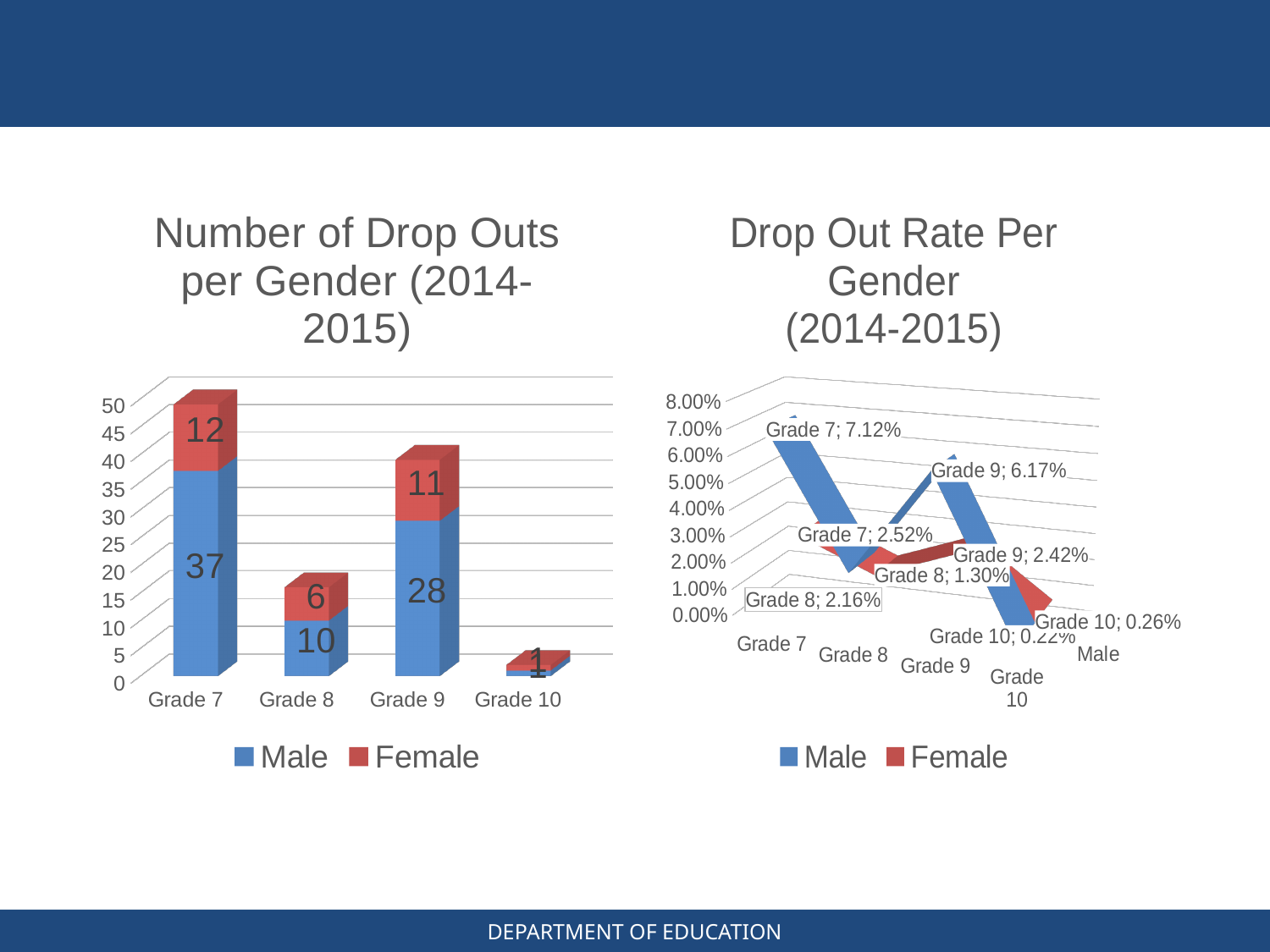
In the 'Number of Drop Outs per Gender (2014-2015)' chart, how many female drop outs are shown for Grade 9? 11 In the 'Drop Out Rate Per Gender (2014-2015)' chart, what is the male drop out rate for Grade 7? 7.12% In the 'Drop Out Rate Per Gender (2014-2015)' chart, what is the female drop out rate for Grade 9? 2.42% What type of chart is the 'Number of Drop Outs per Gender (2014-2015)' chart? Bar chart In the 'Number of Drop Outs per Gender (2014-2015)' chart, what is the total number of drop outs (male plus female) for Grade 7? 49 In the 'Number of Drop Outs per Gender (2014-2015)' chart, what is the total number of drop outs (male plus female) for Grade 8? 16 In the 'Number of Drop Outs per Gender (2014-2015)' chart, which grade has the highest number of male drop outs? Grade 7 How many series does the legend of the 'Drop Out Rate Per Gender (2014-2015)' chart list? 2 In the 'Number of Drop Outs per Gender (2014-2015)' chart, how many more male drop outs are there in Grade 7 than in Grade 9? 9 How many grade categories are shown on the x axis of the 'Number of Drop Outs per Gender (2014-2015)' chart? 4 In the 'Drop Out Rate Per Gender (2014-2015)' chart, which is larger for Grade 9: the male rate or the female rate? Male In the 'Number of Drop Outs per Gender (2014-2015)' chart, how many male drop outs are shown for Grade 7? 37